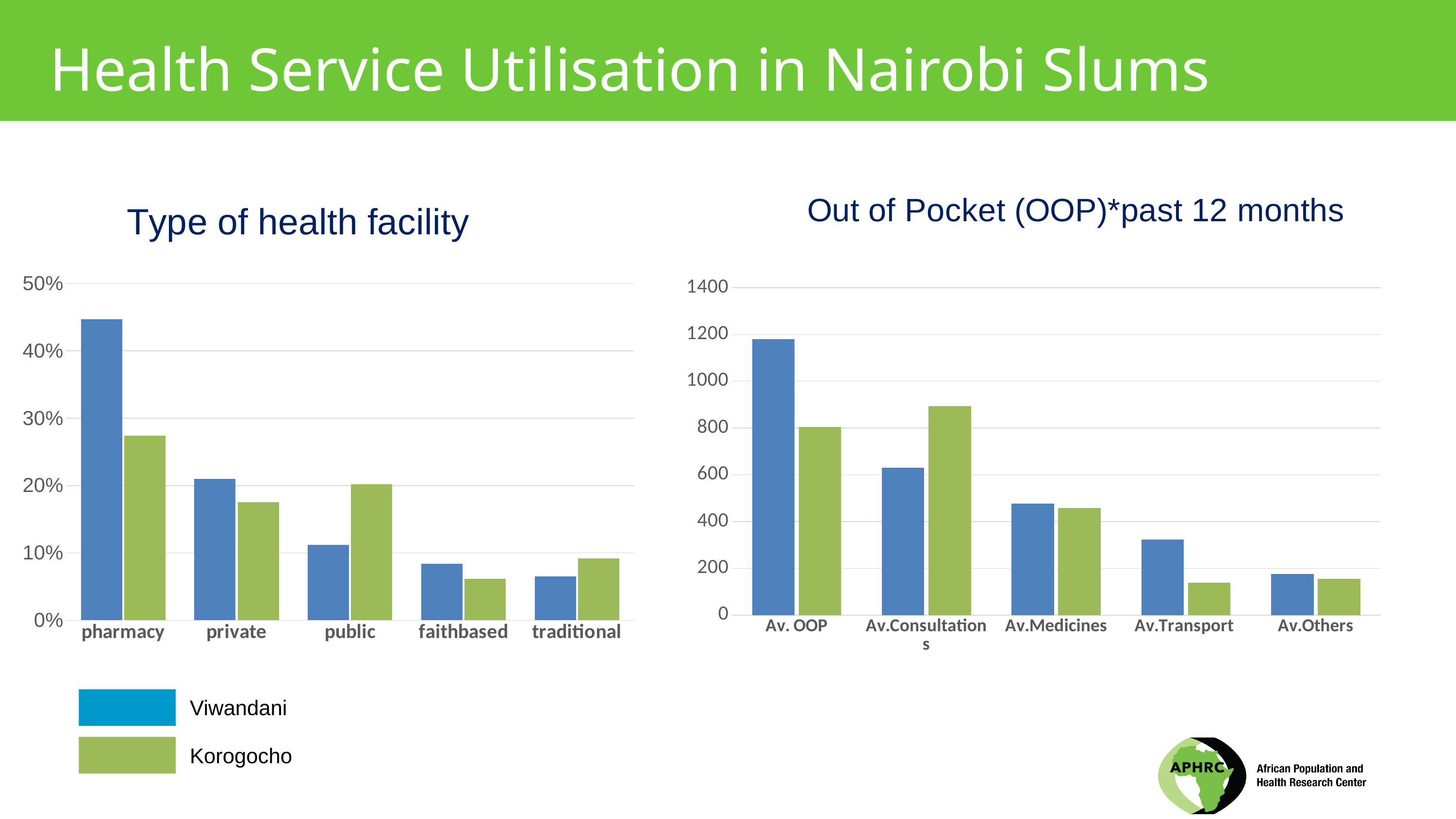
In the "Type of health facility" chart, how many facility types are shown on the x axis? 5 In the "Type of health facility" chart, which facility type has the lowest value for Korogocho? faithbased In the "Type of health facility" chart, which facility type has the highest value for Viwandani? pharmacy In the "Out of Pocket (OOP)*past 12 months" chart, is the Korogocho value for Av.Transport greater or less than 200? less In the "Type of health facility" chart, is the Viwandani value for pharmacy greater or less than 40%? greater In the "Out of Pocket (OOP)*past 12 months" chart, which is larger for Av.Consultations: Viwandani or Korogocho? Korogocho What kind of chart is the "Type of health facility" chart? bar chart In the "Out of Pocket (OOP)*past 12 months" chart, which category has the highest value for Viwandani? Av. OOP In the "Out of Pocket (OOP)*past 12 months" chart, is the Viwandani value for Av. OOP greater or less than 1000? greater In the "Type of health facility" chart, which is larger for public: Viwandani or Korogocho? Korogocho How many series does the legend list? 2